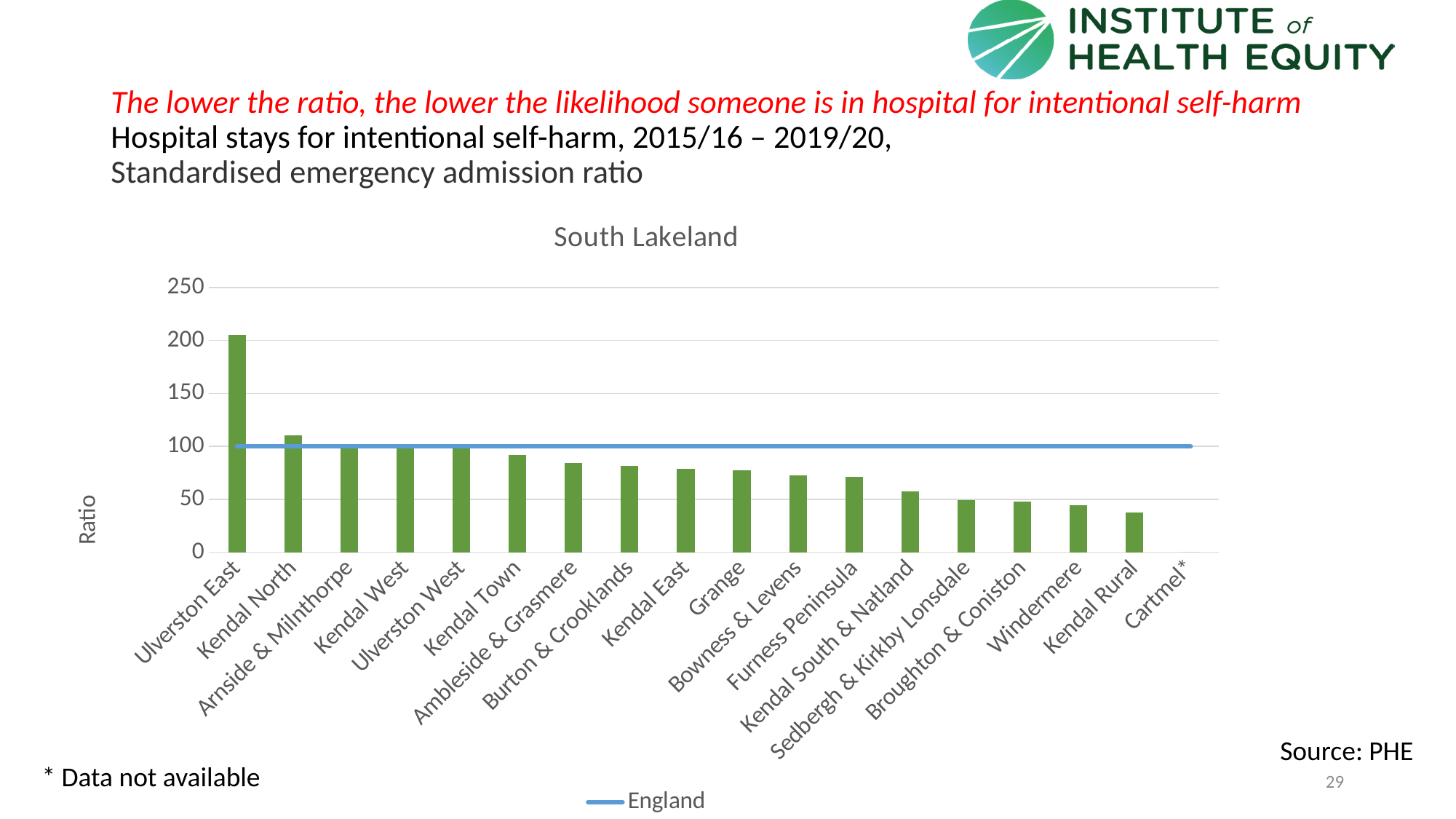
Which has a higher ratio, Ulverston East or Kendal North? Ulverston East Which area has the highest ratio in the chart? Ulverston East Do the bar values rise or fall from left to right along the x axis? fall Is the value for Kendal North greater or less than 100? greater How many areas are listed along the x axis of the chart? 18 Is the value for Ulverston East greater or less than 150? greater What kind of chart is shown on the slide? bar chart Is the value for Kendal Town greater or less than 100? less How many series does the legend list? 1 What is the title of the chart? South Lakeland Which area with a plotted bar has the lowest ratio? Kendal Rural